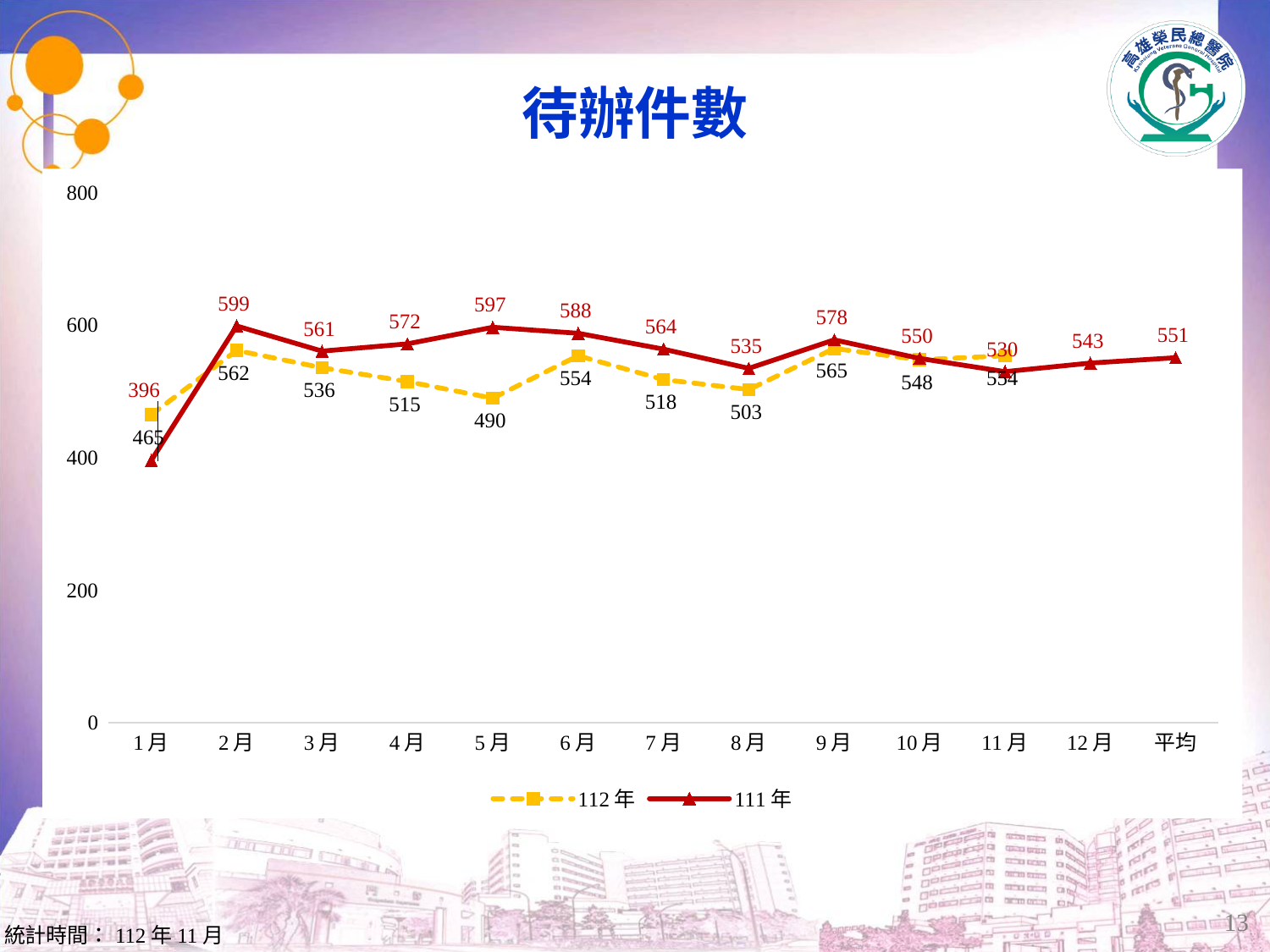
How many series does the legend list? 2 What is the difference between the 111年 and 112年 values in 5月? 107 In which month does the 111年 series reach its highest value? 2月 What is the value for 112年 in 5月? 490 How many categories are shown on the x axis? 13 In which month is the 111年 series lowest? 1月 What is the value for 111年 in 2月? 599 What is the difference between the 111年 and 112年 values in 2月? 37 What is the 平均 value for the 111年 series? 551 In 9月, which series has the larger value, 111年 or 112年? 111年 What kind of chart is shown on the slide? Line chart In which month is the 112年 series lowest? 1月